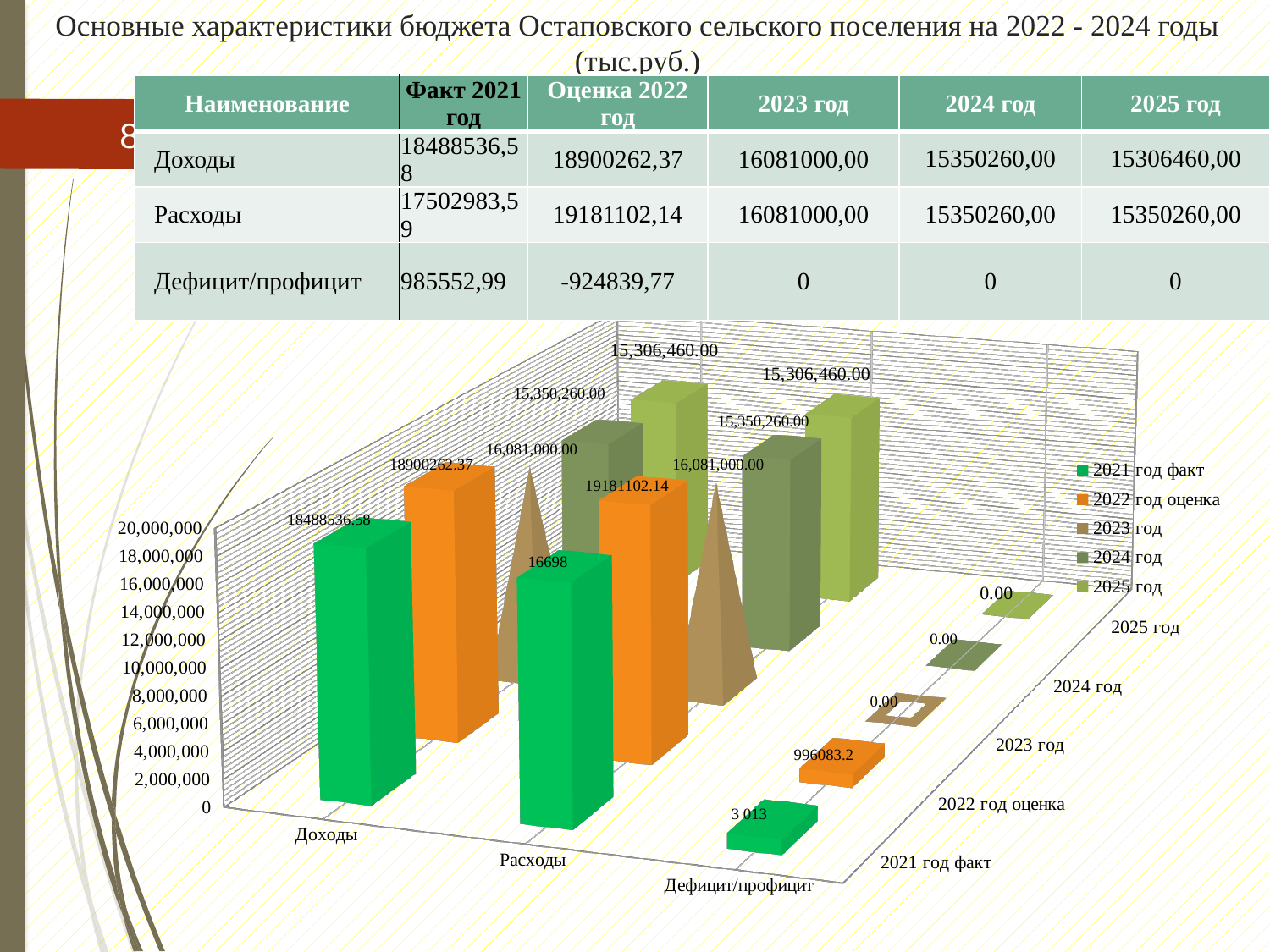
What kind of chart is shown on the slide? bar chart How many categories are shown along the chart's category axis? 3 What is the difference between the Доходы values for 2023 год and 2024 год in the chart? 730,740.00 How many series does the chart legend list? 5 What is the value of Дефицит/профицит for the 2022 год оценка series in the chart? 996083.2 What is the value of Доходы for the 2025 год series in the chart? 15,306,460.00 Which is larger in the chart: Расходы for 2022 год оценка or Расходы for 2023 год? 2022 год оценка Which series has the lowest value for Доходы in the chart? 2025 год What is the value of Расходы for the 2023 год series in the chart? 16,081,000.00 What is the last entry listed in the chart legend? 2025 год Which series has the highest value for Доходы in the chart? 2022 год оценка What is the value of Доходы for the 2022 год оценка series in the chart? 18900262.37